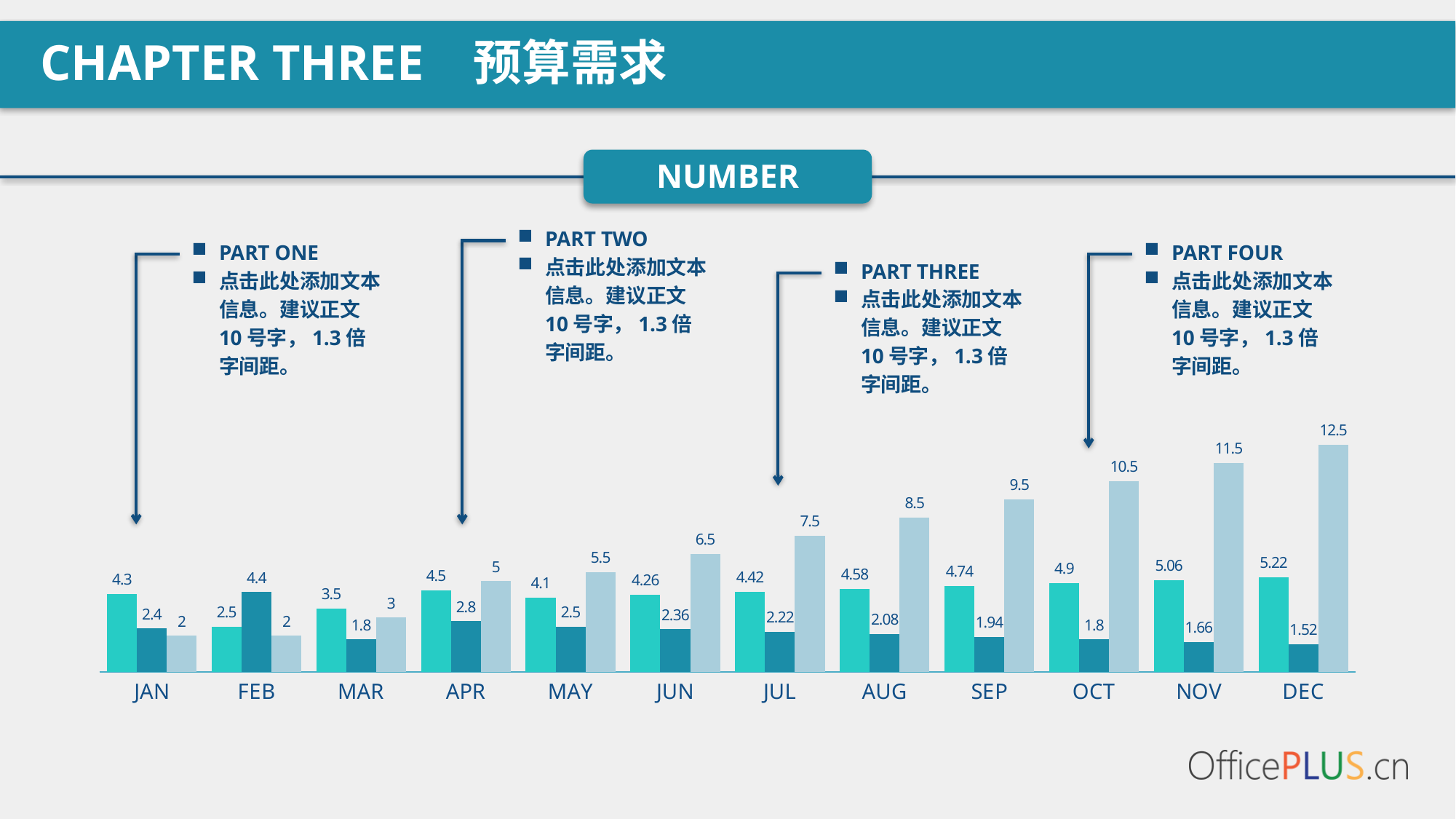
What is the value of the bright teal (first) bar for JAN? 4.3 What is the label shown in the box above the chart? NUMBER What is the value of the dark teal (middle) bar for FEB? 4.4 Which month has the highest light blue bar? DEC What is the value of the light blue bar for DEC? 12.5 What is the difference between the light blue bar and the dark teal bar for DEC? 10.98 What is the value of the dark teal (middle) bar for SEP? 1.94 Do the light blue bars rise or fall from APR to DEC? rise How many months are shown on the x axis of the chart? 12 Which month has the lowest dark teal (middle) bar? DEC What type of chart is shown on the slide? bar chart Which is larger for MAR: the bright teal bar or the light blue bar? bright teal bar